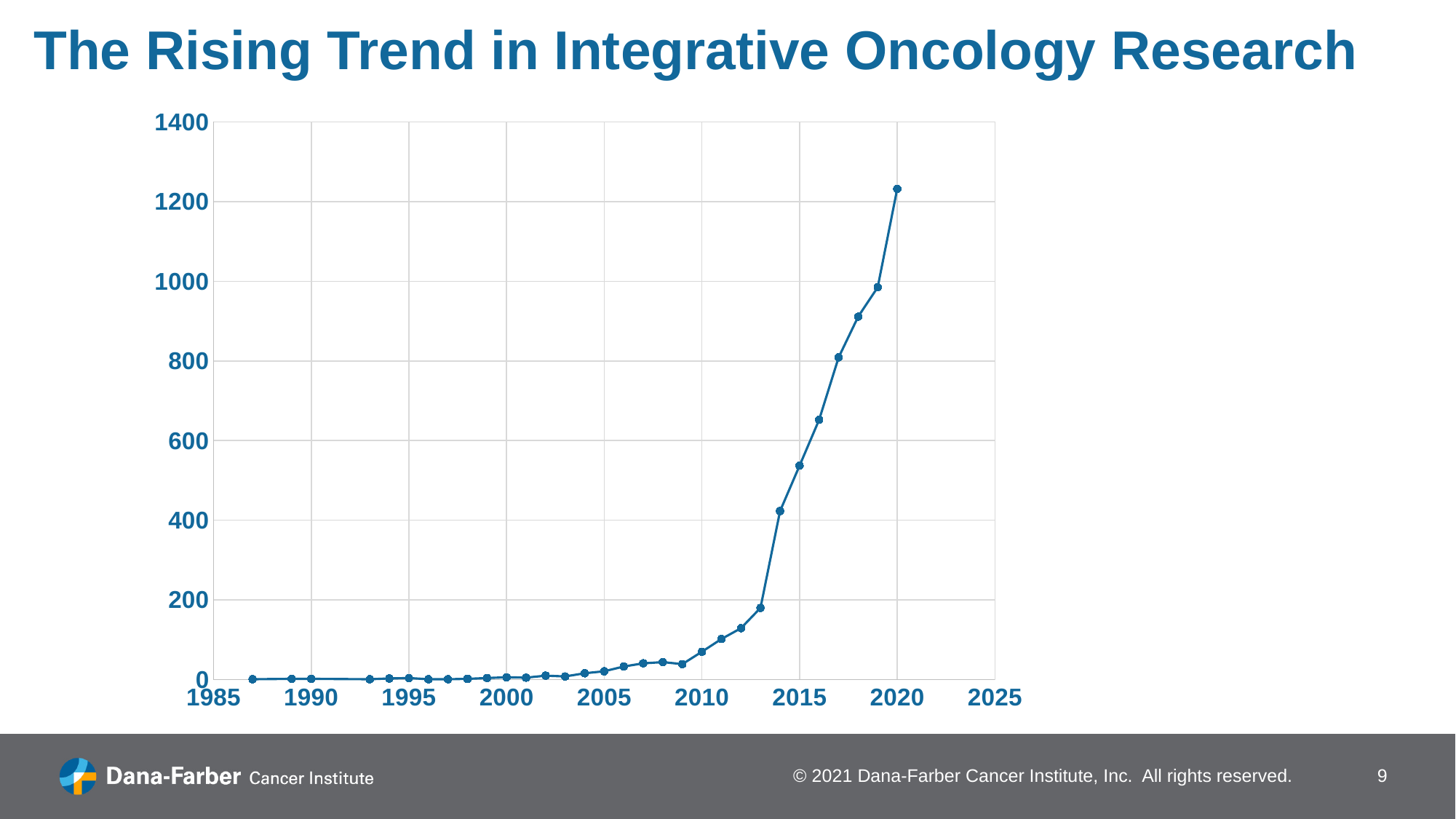
Is the value for 2020 greater or less than 1200? greater Is the value for 2015 greater or less than 600? less What kind of chart is shown on the slide? line chart What is the highest value shown on the y axis? 1400 Is the value for 2010 greater or less than 200? less Which year has the larger value, 2010 or 2020? 2020 Which year has the highest value on the chart? 2020 Do the values generally rise or fall as the years increase along the x axis? rise What is the title of the chart? The Rising Trend in Integrative Oncology Research